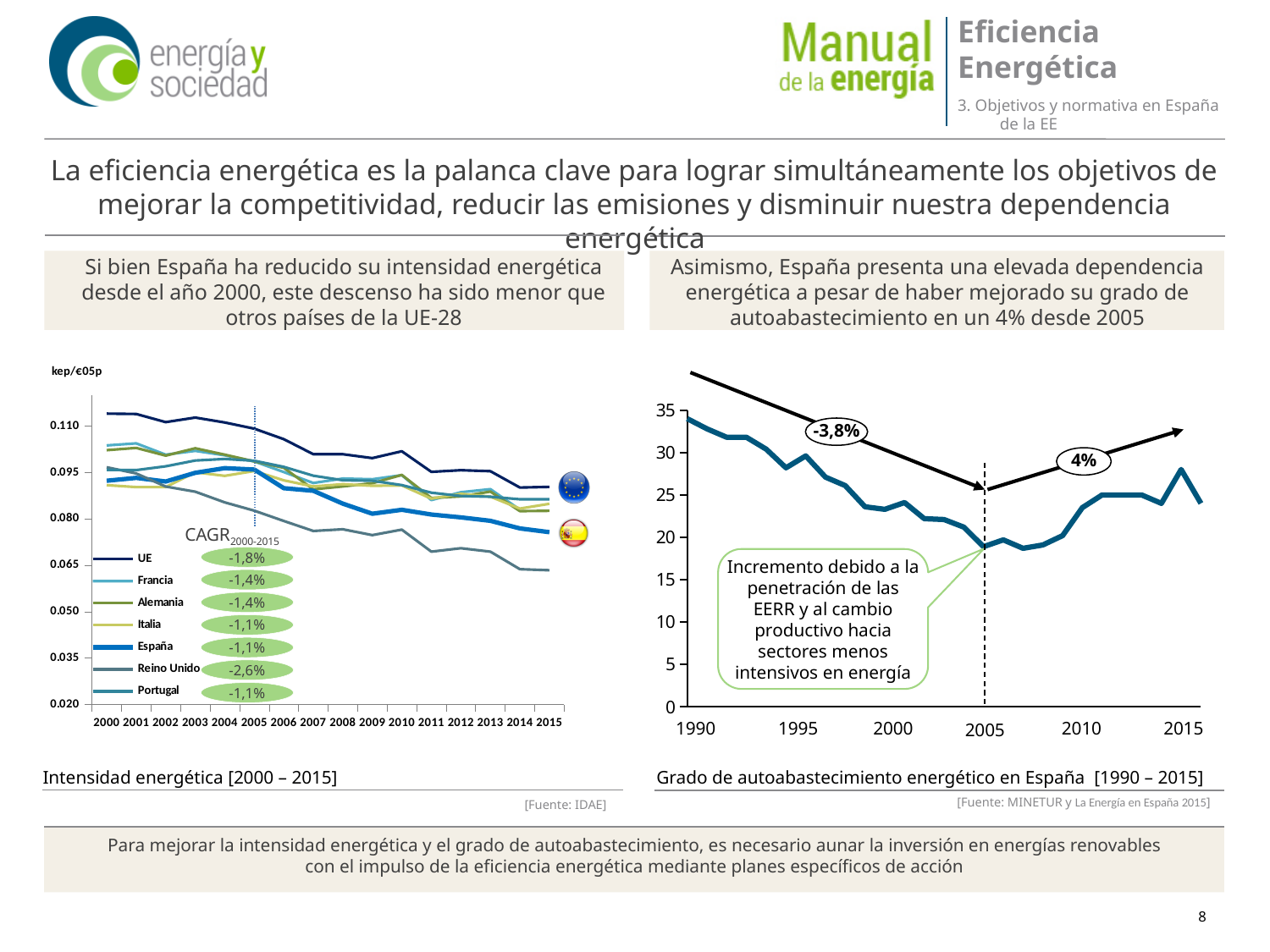
In the 'Intensidad energética [2000 – 2015]' chart, which country has the most negative CAGR 2000-2015? Reino Unido In the 'Intensidad energética [2000 – 2015]' chart, which series has the highest value in 2000? UE In the 'Grado de autoabastecimiento energético en España [1990 – 2015]' chart, what percentage change is annotated on the arrow for the period after 2005? 4% What kind of chart is the 'Grado de autoabastecimiento energético en España [1990 – 2015]' chart on the right? line chart How many series does the legend of the 'Intensidad energética [2000 – 2015]' chart list? 7 In the 'Grado de autoabastecimiento energético en España [1990 – 2015]' chart, is the value in 1990 greater or less than 30? greater In the 'Intensidad energética [2000 – 2015]' chart, is the value for España in 2015 greater or less than 0.080? less In the 'Grado de autoabastecimiento energético en España [1990 – 2015]' chart, do the values rise or fall between 1990 and 2005? fall In the 'Intensidad energética [2000 – 2015]' chart, what is the CAGR 2000-2015 shown for UE? -1,8% In the 'Intensidad energética [2000 – 2015]' chart, what is the CAGR 2000-2015 shown for Reino Unido? -2,6% What kind of chart is the 'Intensidad energética [2000 – 2015]' chart on the left? line chart In the 'Intensidad energética [2000 – 2015]' chart, which series has the lowest value in 2015? Reino Unido